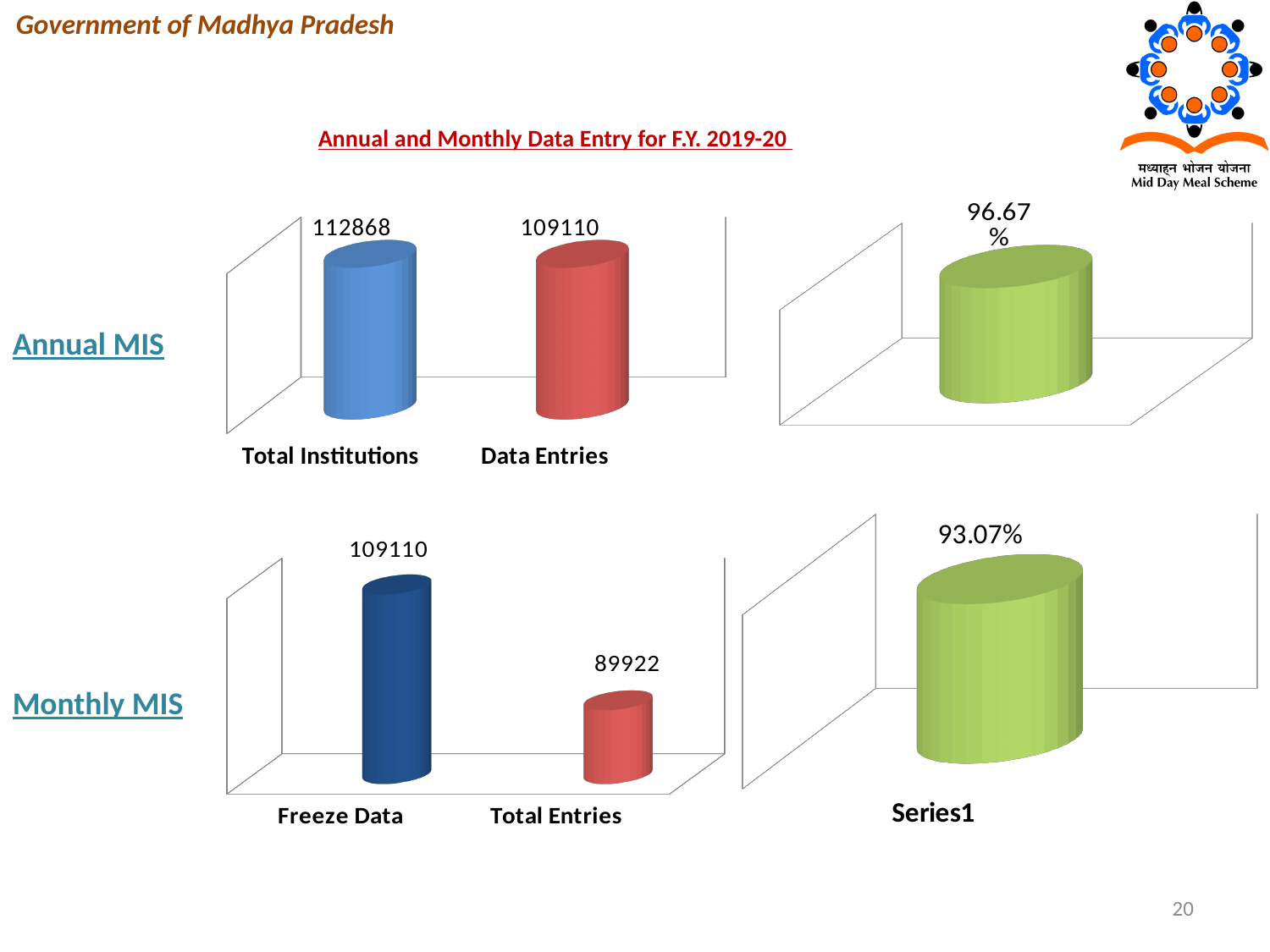
In the Monthly MIS bar chart on the left, what is the value for Total Entries? 89922 In the Monthly MIS bar chart on the left, which category has the lower value? Total Entries In the Annual MIS chart on the right, what percentage is shown on the bar? 96.67% How many categories are shown in the Monthly MIS bar chart on the left? 2 What type of chart is the Annual MIS chart on the left? Bar chart In the Annual MIS bar chart on the left, what is the value for Data Entries? 109110 In the Annual MIS bar chart on the left, which category has the higher value? Total Institutions In the Annual MIS bar chart on the left, what is the value for Total Institutions? 112868 In the Monthly MIS bar chart on the left, what is the value for Freeze Data? 109110 In the Monthly MIS chart on the right, what percentage is shown on the bar? 93.07% In the Annual MIS bar chart on the left, what is the difference between Total Institutions and Data Entries? 3758 In the Monthly MIS bar chart on the left, what is the difference between Freeze Data and Total Entries? 19188